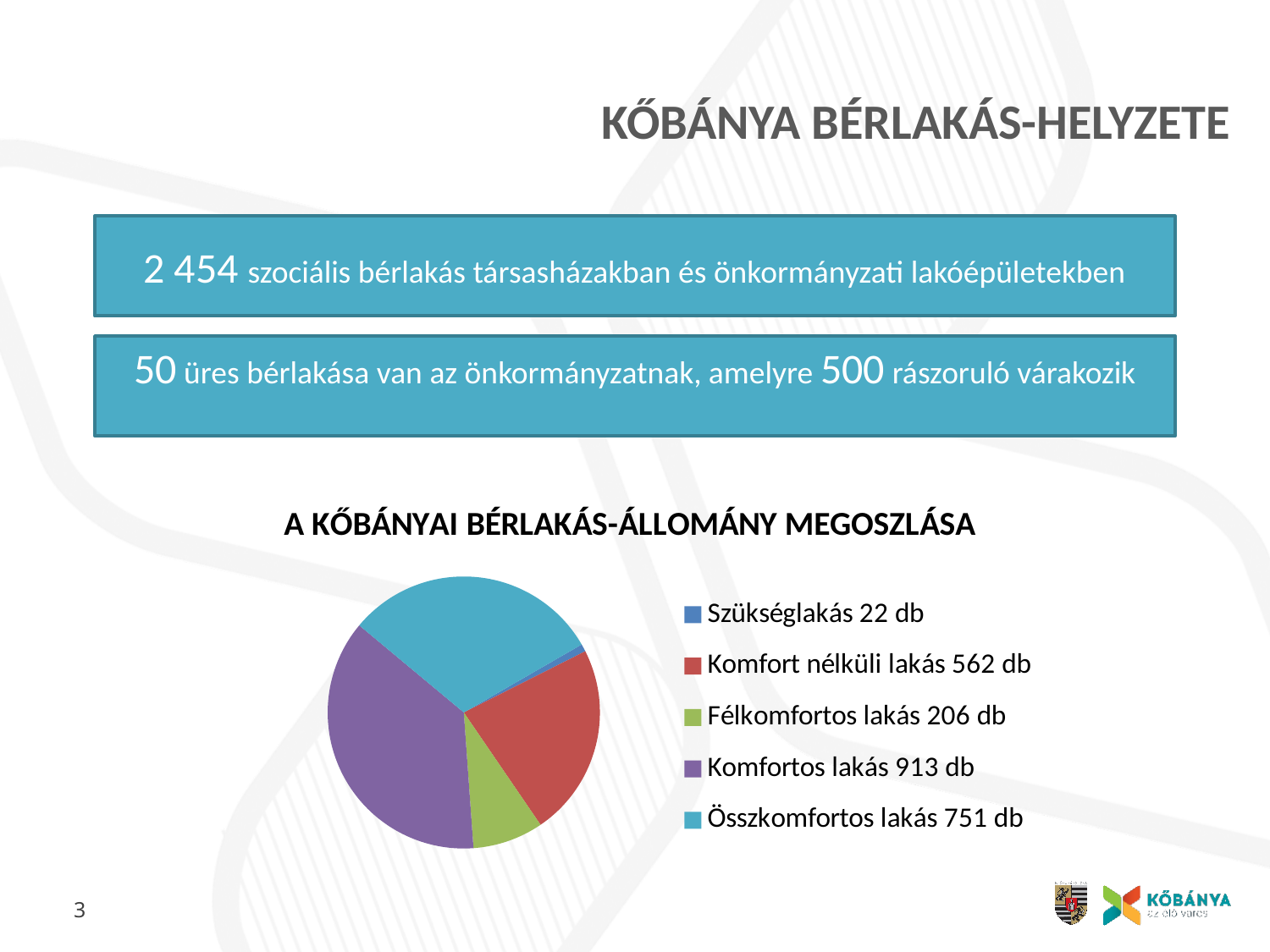
What is the value for Félkomfortos lakás in the pie chart? 206 db Which is larger in the pie chart, Komfort nélküli lakás or Félkomfortos lakás? Komfort nélküli lakás How many categories does the pie chart have? 5 What is the difference between Komfortos lakás and Összkomfortos lakás in the pie chart? 162 db What is the total of all categories in the pie chart? 2 454 db What kind of chart is shown on the slide? Pie chart What is the value for Komfortos lakás in the pie chart? 913 db Which category has the largest slice in the pie chart? Komfortos lakás Which category has the smallest slice in the pie chart? Szükséglakás What is the value for Szükséglakás in the pie chart? 22 db What colour is the Komfortos lakás slice in the pie chart? Purple What is the title of the pie chart? A KŐBÁNYAI BÉRLAKÁS-ÁLLOMÁNY MEGOSZLÁSA